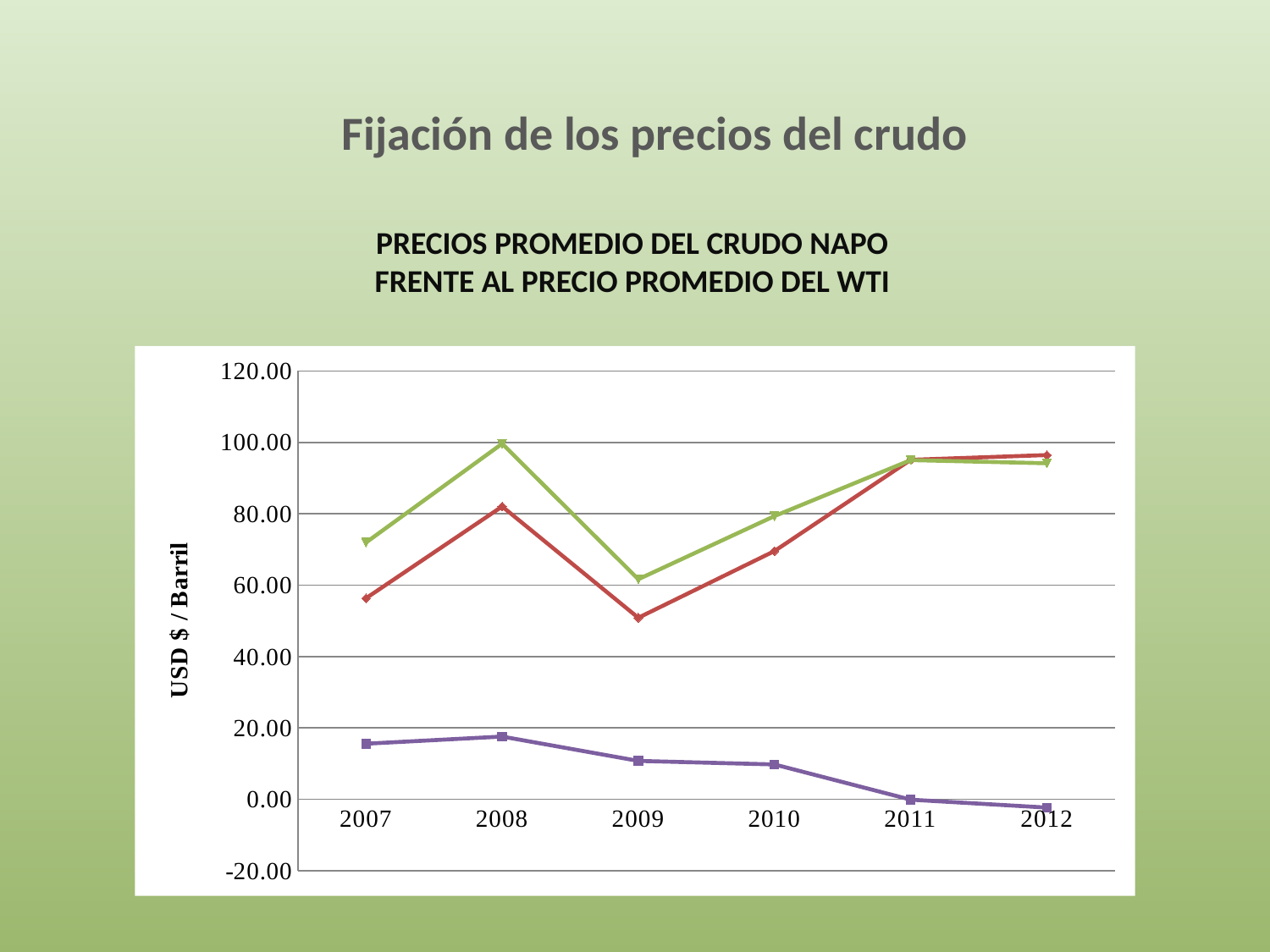
Does the purple line generally rise or fall from 2007 to 2012? fall How many years are shown on the x axis of the chart? 6 Is the value of the green line in 2010 greater or less than 100.00? less What kind of chart is shown on the slide? line chart What is the title of the chart? PRECIOS PROMEDIO DEL CRUDO NAPO FRENTE AL PRECIO PROMEDIO DEL WTI In which year does the red line reach its lowest value? 2009 What is the label of the vertical axis of the chart? USD $ / Barril In 2008, which line has the larger value, the green line or the red line? the green line In which year does the green line reach its highest value? 2008 Is the value of the red line in 2007 greater or less than 60.00? less Is the value of the red line in 2009 greater or less than 40.00? greater